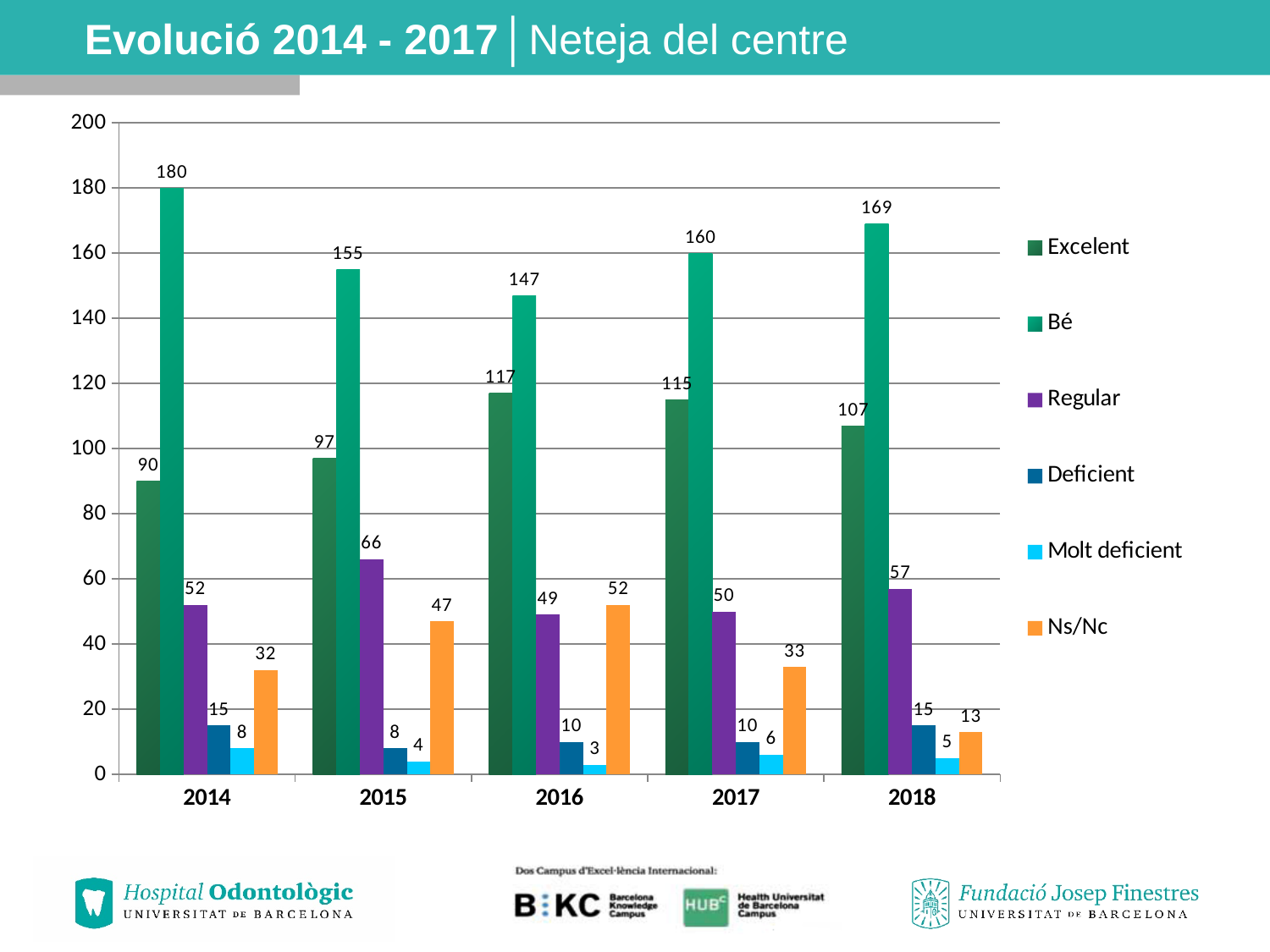
How many series does the legend list? 6 What kind of chart is shown on the slide? Bar chart In which year is the Ns/Nc value lowest? 2018 Which year has the larger Excelent value, 2016 or 2017? 2016 Does the Excelent value rise or fall from 2014 to 2016? Rise How many years are shown on the x axis? 5 What is the value for Molt deficient in 2016? 3 What is the difference between the Bé and Excelent values in 2018? 62 In which year is the Bé value highest? 2014 What colour represents Ns/Nc in the legend? Orange What is the value for Regular in 2015? 66 What is the value for Bé in 2014? 180